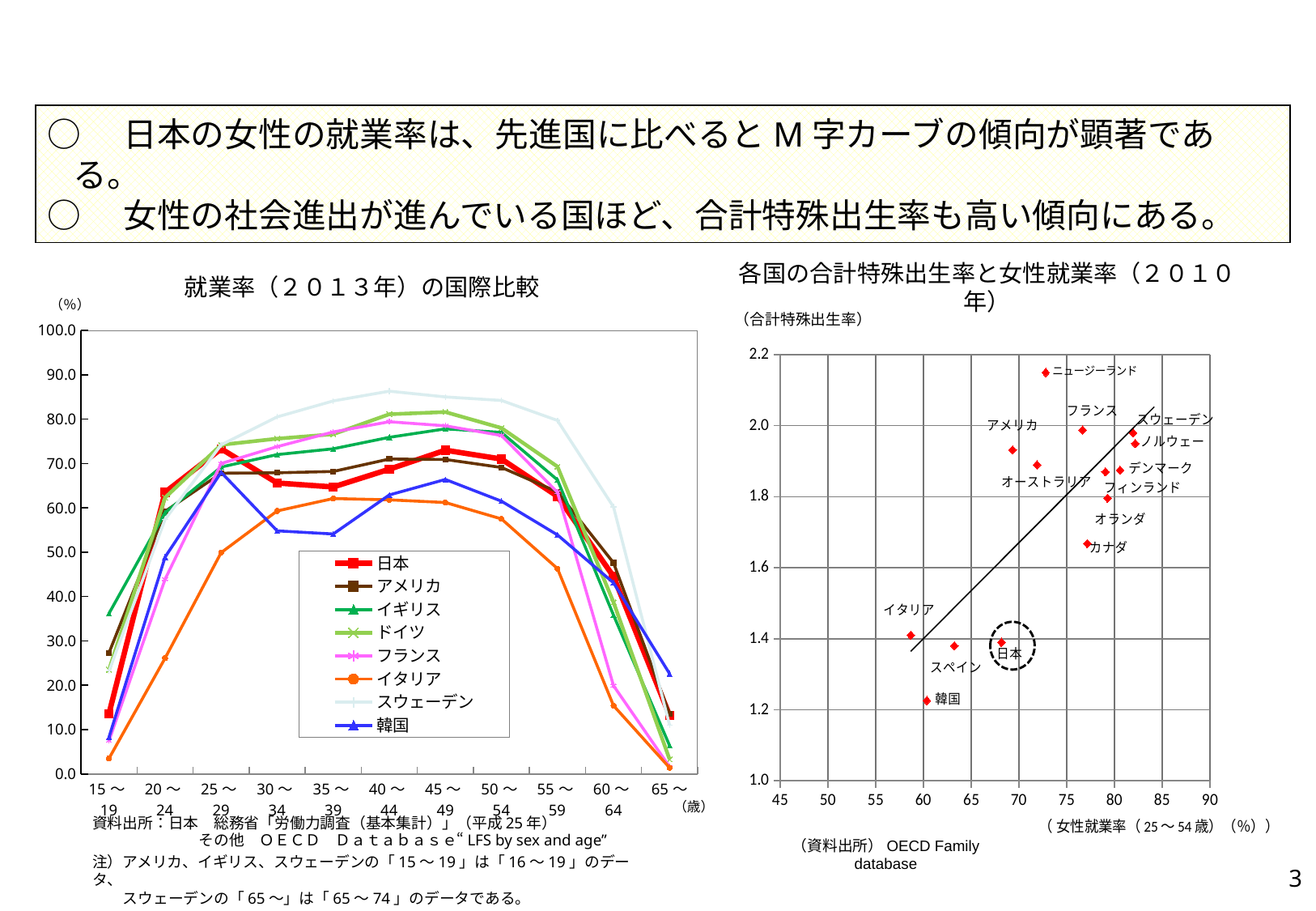
In the left chart 就業率（２０１３年）の国際比較, which country has the lowest value at 15～19? イタリア In the left chart 就業率（２０１３年）の国際比較, which country has the highest value at 40～44? スウェーデン In the right chart 各国の合計特殊出生率と女性就業率（２０１０年）, what kind of chart is it? scatter chart In the left chart 就業率（２０１３年）の国際比較, what kind of chart is it? line chart In the left chart 就業率（２０１３年）の国際比較, how many age categories are on the x axis? 11 In the left chart 就業率（２０１３年）の国際比較, is the value for 韓国 at 30～34 greater or less than 60.0? less In the left chart 就業率（２０１３年）の国際比較, how many series does the legend list? 8 In the right chart 各国の合計特殊出生率と女性就業率（２０１０年）, which country has the lowest 合計特殊出生率? 韓国 In the right chart 各国の合計特殊出生率と女性就業率（２０１０年）, which country is highlighted with a dashed circle? 日本 In the right chart 各国の合計特殊出生率と女性就業率（２０１０年）, which country has the highest 合計特殊出生率? ニュージーランド In the left chart 就業率（２０１３年）の国際比較, is the value for 日本 at 35～39 greater or less than 60.0? greater In the left chart 就業率（２０１３年）の国際比較, which is larger at 25～29, 日本 or イタリア? 日本